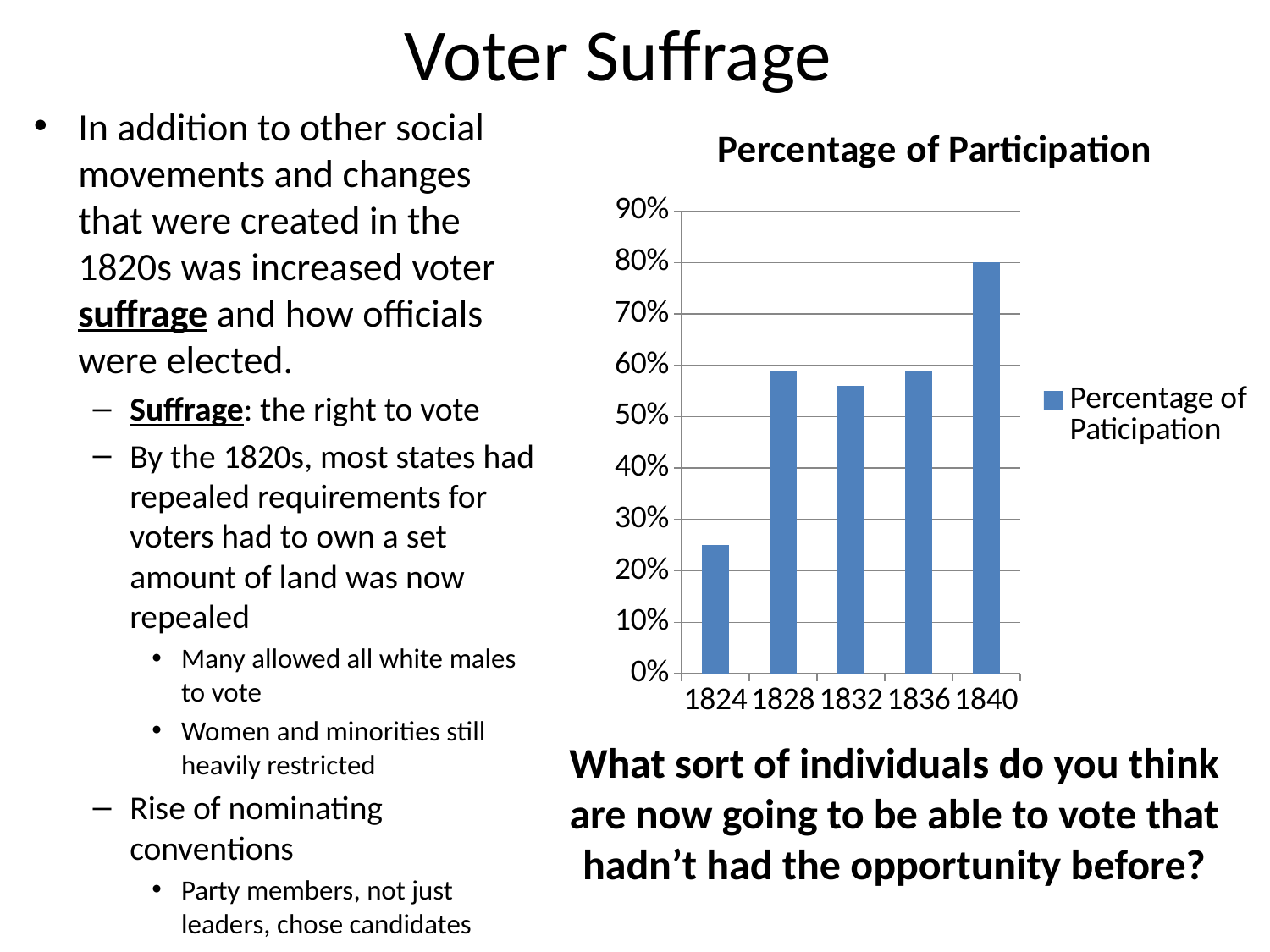
Which is larger, the value for 1832 or the value for 1840? 1840 Is the value for 1832 greater or less than 50%? greater Is the value for 1824 greater or less than 30%? less How many series does the chart's legend list? 1 What kind of chart is shown on the slide? bar chart Overall, do the values rise or fall from 1824 to 1840? rise What is the percentage of participation for 1840? 80% What is the title of the chart? Percentage of Participation How many years are shown on the x axis of the chart? 5 Which year has the lowest percentage of participation? 1824 Which year has the highest percentage of participation? 1840